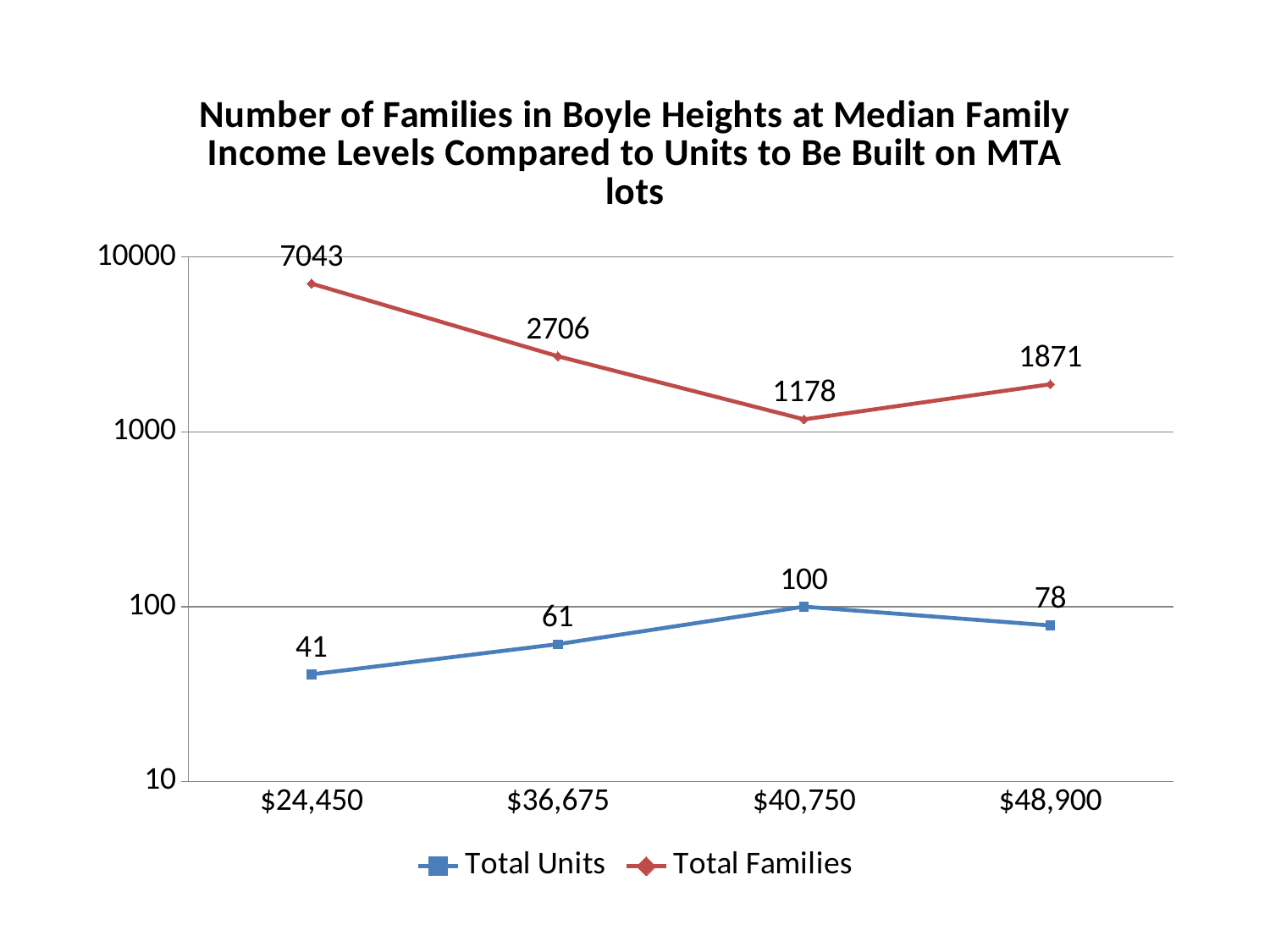
What is the value of Total Units at the $40,750 income level? 100 What kind of chart is shown on the slide? Line chart How many series does the legend list? 2 At which income level is Total Families lowest? $40,750 Does Total Units rise or fall from $24,450 to $40,750? Rise What is the value of Total Units at the $48,900 income level? 78 What is the difference between Total Units at $40,750 and at $24,450? 59 At which income level is Total Units highest? $40,750 What is the difference between Total Families at $24,450 and at $36,675? 4337 How many income levels are shown on the x axis? 4 What is the value of Total Families at the $24,450 income level? 7043 Which is larger: Total Families at $36,675 or Total Families at $48,900? Total Families at $36,675